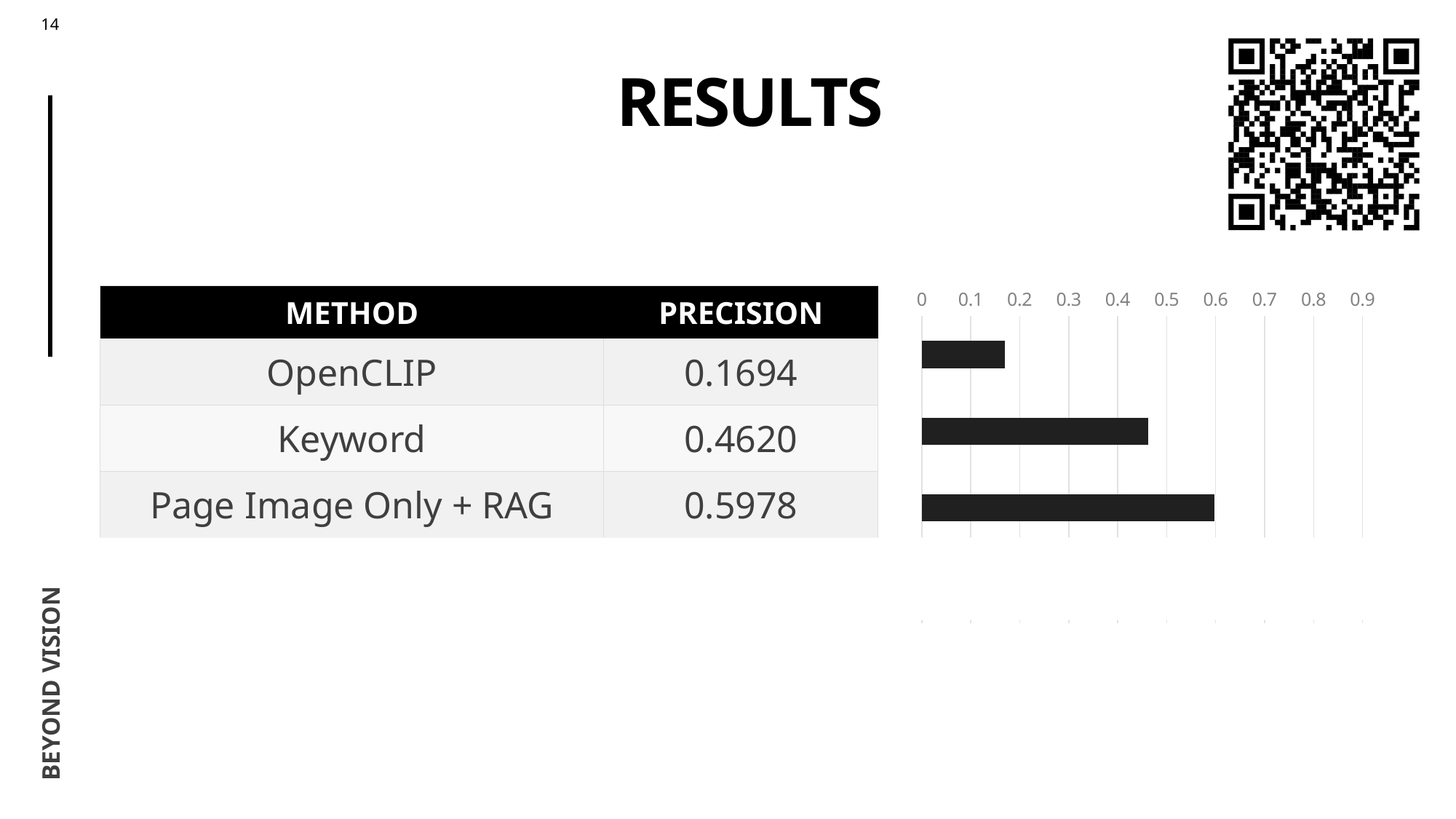
What is the highest tick label shown on the chart's value axis? 0.9 What is the precision value for OpenCLIP? 0.1694 What is the difference in precision between Page Image Only + RAG and Keyword? 0.1358 What is the precision value for Page Image Only + RAG? 0.5978 How many bars does the chart show? 3 What kind of chart is shown on the slide? bar chart Is the bar for Page Image Only + RAG greater or less than 0.5? greater Which has a higher precision, Keyword or OpenCLIP? Keyword What is the difference in precision between Keyword and OpenCLIP? 0.2926 Which method has the highest precision? Page Image Only + RAG Which method has the lowest precision? OpenCLIP What is the precision value for Keyword? 0.4620